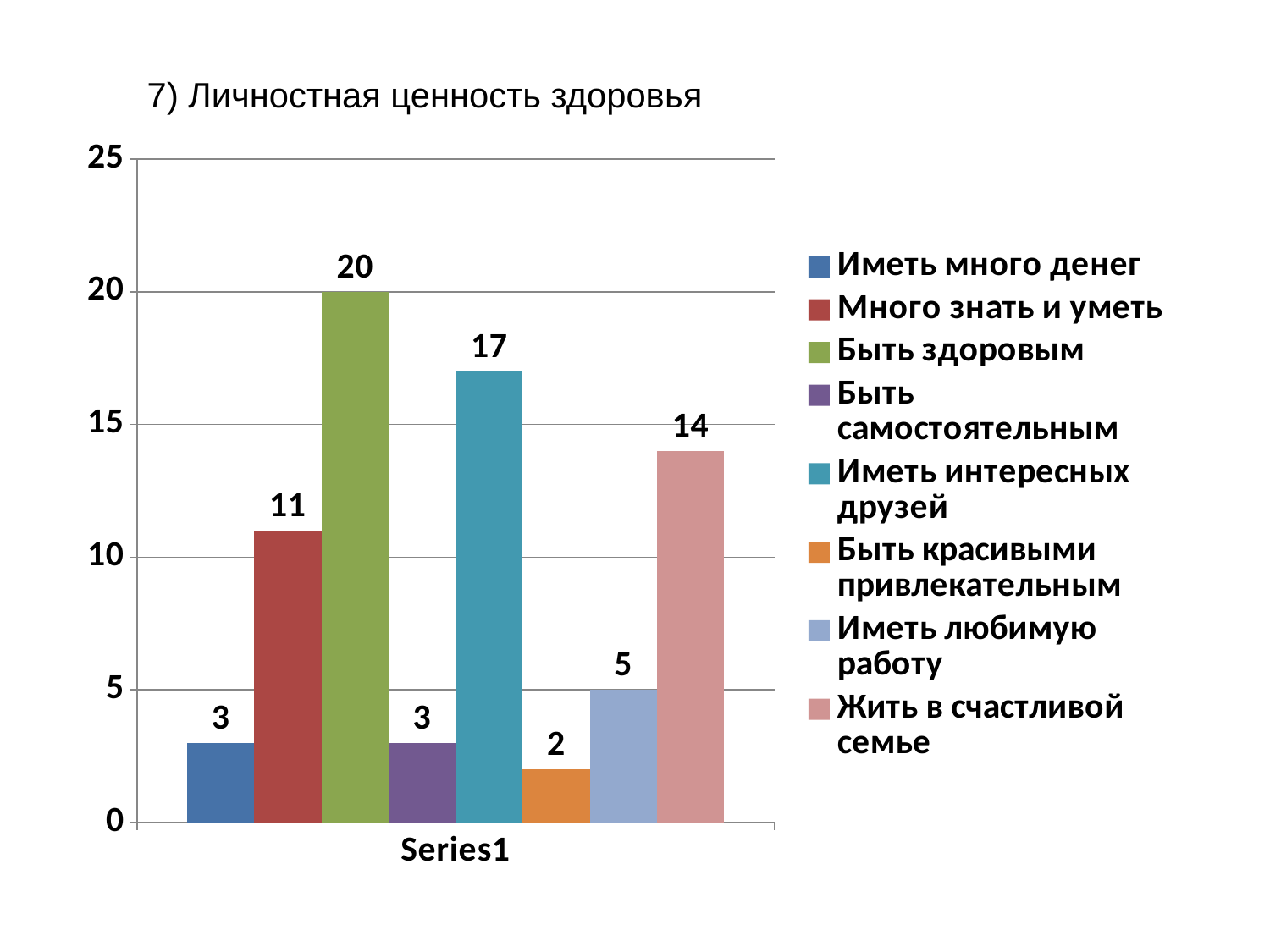
What is the difference between the values for "Быть здоровым" and "Иметь интересных друзей"? 3 Which category has the highest value? Быть здоровым What is the value for "Жить в счастливой семье"? 14 What is the value for "Быть красивыми привлекательным"? 2 What is the value for "Иметь интересных друзей"? 17 What is the value for "Быть здоровым"? 20 Is the value for "Иметь любимую работу" greater or less than 10? less Which category has the lowest value? Быть красивыми привлекательным Which is larger: the value for "Много знать и уметь" or the value for "Жить в счастливой семье"? Жить в счастливой семье How many series does the legend list? 8 What kind of chart is shown on the slide? bar chart What is the title of the slide above the chart? 7) Личностная ценность здоровья